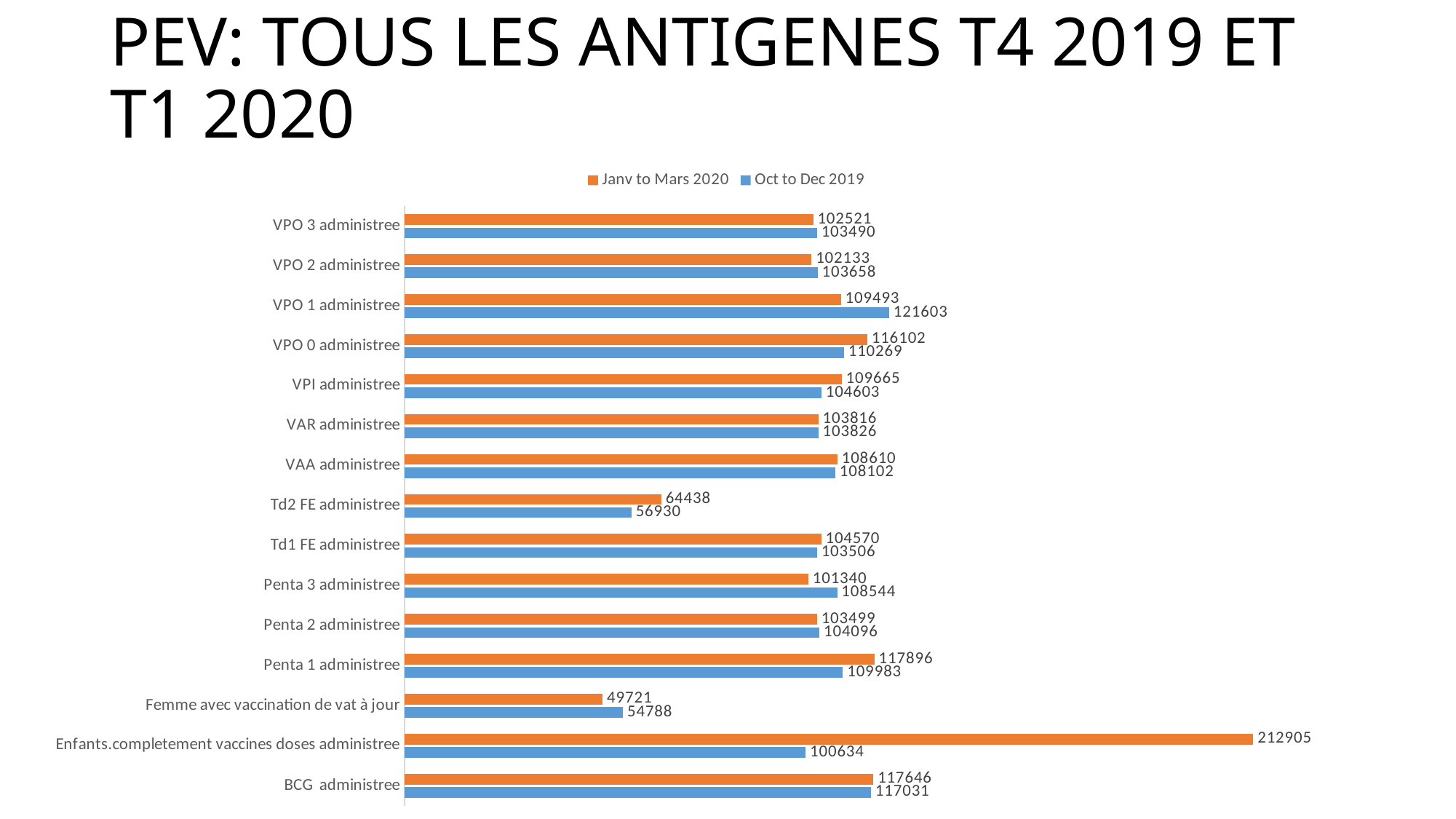
What is the value for Enfants.completement vaccines doses administree in the Janv to Mars 2020 series? 212905 What is the difference between the Oct to Dec 2019 and Janv to Mars 2020 values for VPO 1 administree? 12110 How many series does the legend list? 2 Which category has the highest value in the Janv to Mars 2020 series? Enfants.completement vaccines doses administree What is the difference between the Janv to Mars 2020 and Oct to Dec 2019 values for Enfants.completement vaccines doses administree? 112271 What kind of chart is shown on the slide? Bar chart Which category has the highest value in the Oct to Dec 2019 series? VPO 1 administree For Penta 1 administree, which series has the larger value: Janv to Mars 2020 or Oct to Dec 2019? Janv to Mars 2020 What is the value for Td2 FE administree in the Oct to Dec 2019 series? 56930 Which category has the lowest value in the Janv to Mars 2020 series? Femme avec vaccination de vat à jour How many categories are shown on the chart? 15 What is the value for VPO 1 administree in the Oct to Dec 2019 series? 121603